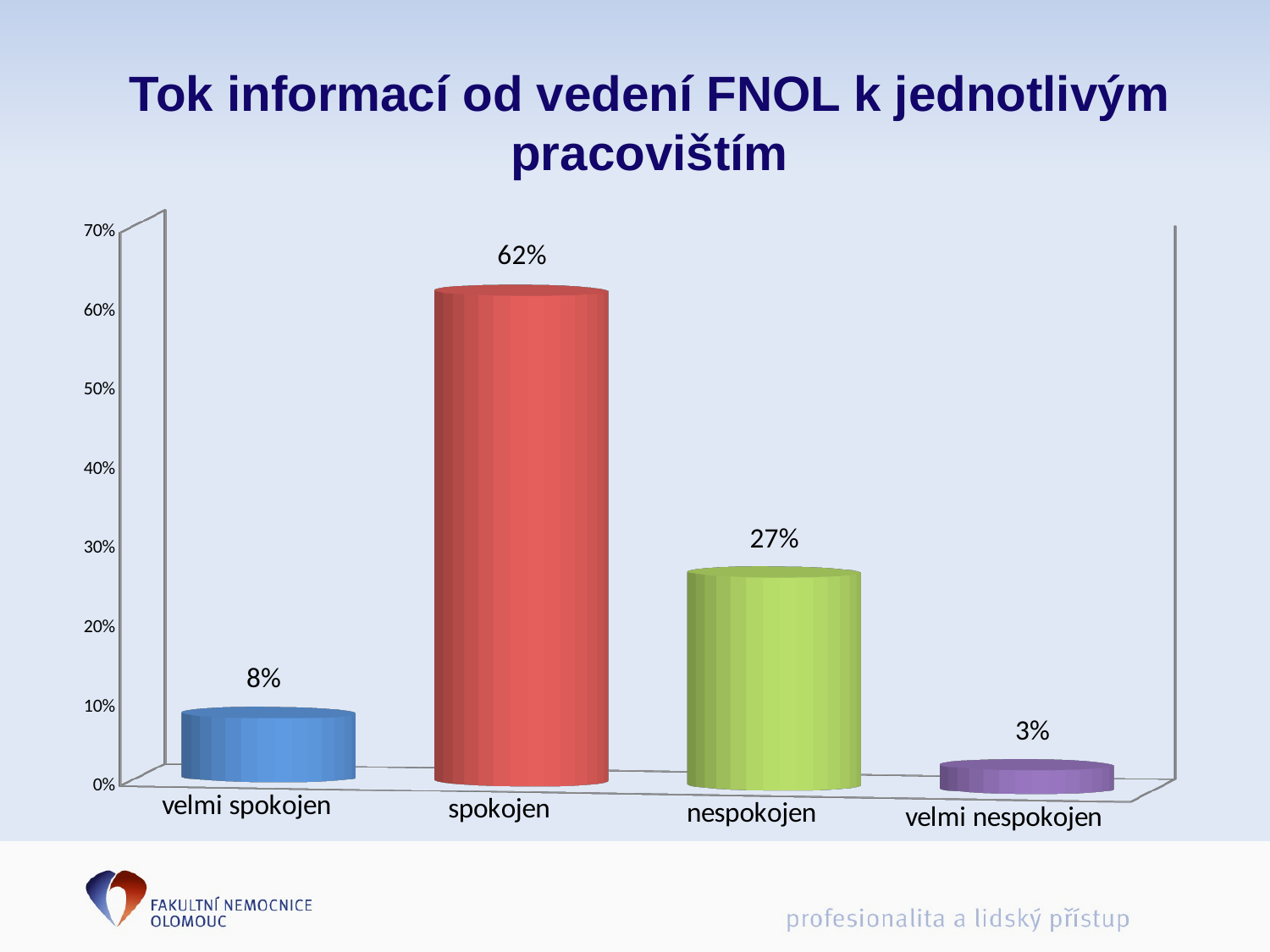
How many categories are shown on the x axis? 4 What is the difference between the values for "spokojen" and "nespokojen"? 35% What is the value for "velmi nespokojen"? 3% What is the value for "velmi spokojen"? 8% What is the value for "spokojen"? 62% What is the difference between the values for "velmi spokojen" and "velmi nespokojen"? 5% What kind of chart is shown on the slide? bar chart What is the value for "nespokojen"? 27% Which category has the highest value? spokojen Which category has the lowest value? velmi nespokojen Which is larger, the value for "nespokojen" or the value for "velmi spokojen"? nespokojen What is the title of the chart? Tok informací od vedení FNOL k jednotlivým pracovištím